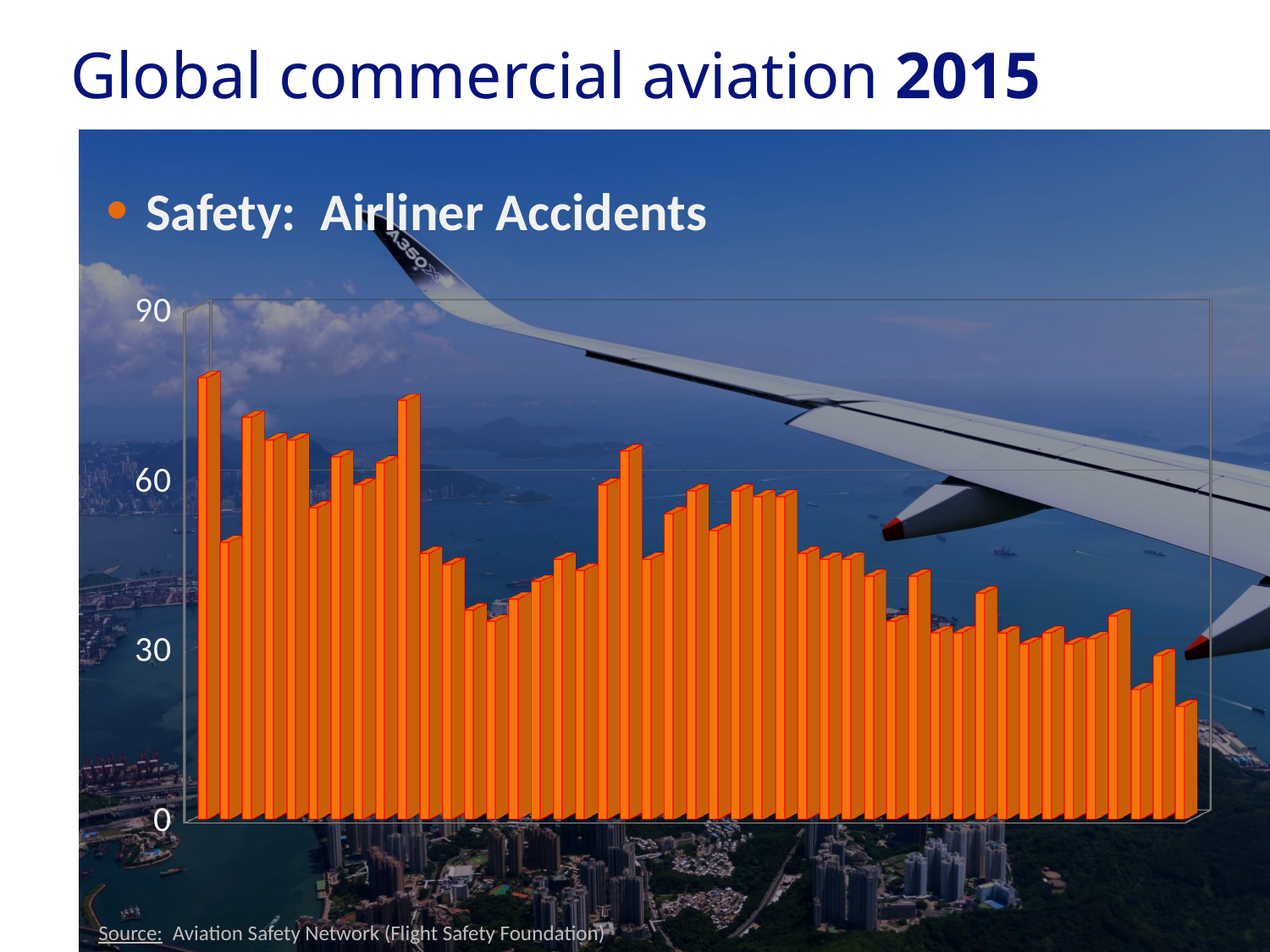
Is the leftmost bar or the rightmost bar larger? leftmost Is the value of the rightmost bar greater or less than 30? less What is the highest value shown on the vertical axis? 90 What kind of chart is shown on the slide? bar chart Is the value of the leftmost bar greater or less than 60? greater Is the value of the leftmost bar greater or less than 90? less What is the heading text above the chart? Safety: Airliner Accidents Do the bar values generally rise or fall from left to right across the chart? fall Which bar is the tallest in the chart, the leftmost or the rightmost? leftmost